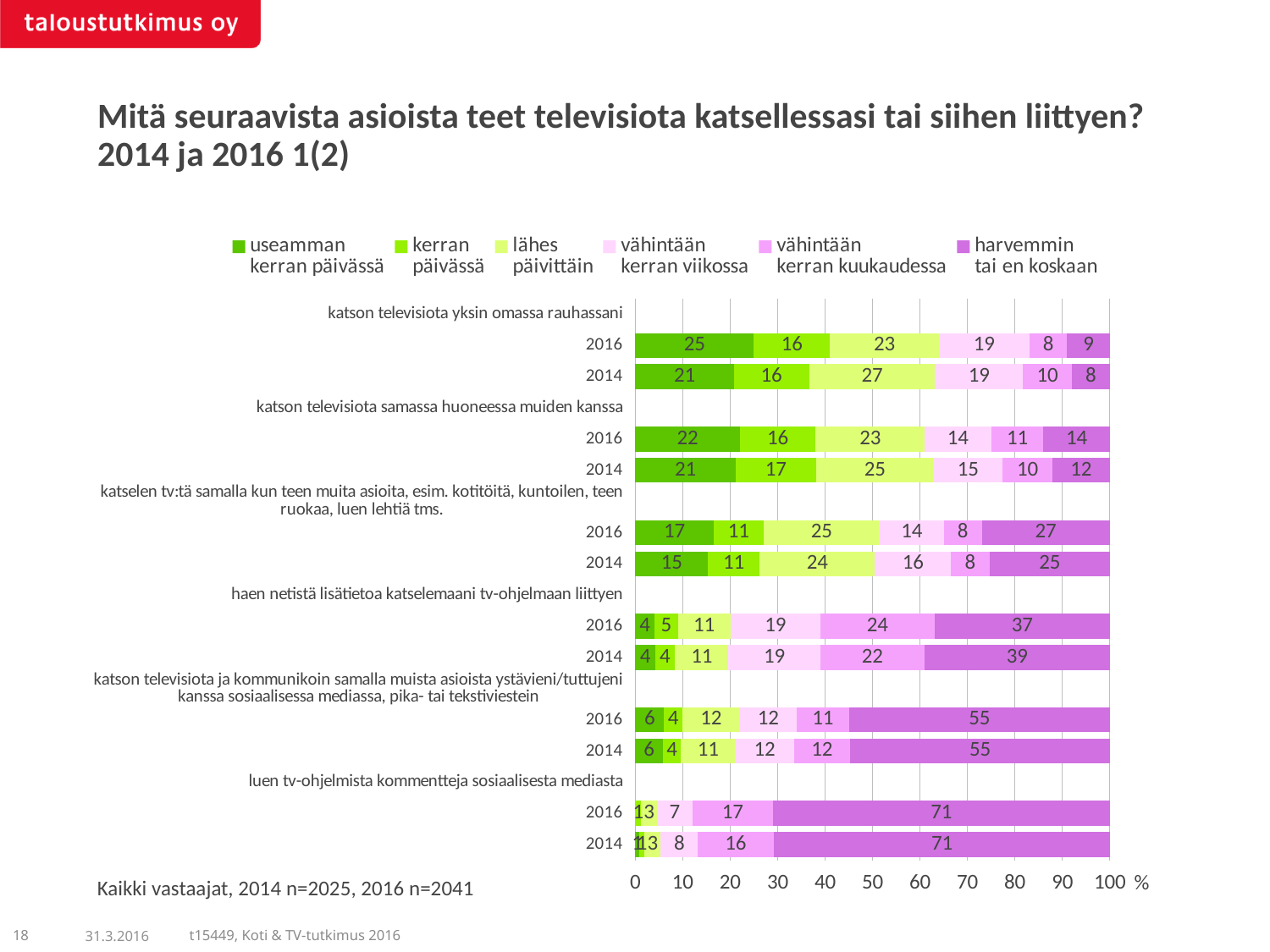
What is the value for 'harvemmin tai en koskaan' for 'haen netistä lisätietoa katselemaani tv-ohjelmaan liittyen' in 2014? 39 How many series does the legend list? 6 What is the value for 'vähintään kerran viikossa' for 'katson televisiota samassa huoneessa muiden kanssa' in 2014? 15 Which series has the smallest value in the 2016 bar for 'katson televisiota yksin omassa rauhassani'? vähintään kerran kuukaudessa What is the value for 'useamman kerran päivässä' for 'katson televisiota yksin omassa rauhassani' in 2016? 25 What is the difference between the 2016 and 2014 values for 'useamman kerran päivässä' for 'katson televisiota yksin omassa rauhassani'? 4 What is the value for 'harvemmin tai en koskaan' for 'katson televisiota ja kommunikoin samalla muista asioista' in 2016? 55 Which is larger for 'katson televisiota samassa huoneessa muiden kanssa': the 'harvemmin tai en koskaan' value in 2016 or in 2014? 2016 What kind of chart is shown on the slide? stacked bar chart Which series has the largest value in the 2016 bar for 'haen netistä lisätietoa katselemaani tv-ohjelmaan liittyen'? harvemmin tai en koskaan How many statements (question items) are shown on the chart? 6 What is the value for 'lähes päivittäin' for 'katselen tv:tä samalla kun teen muita asioita' in 2016? 25